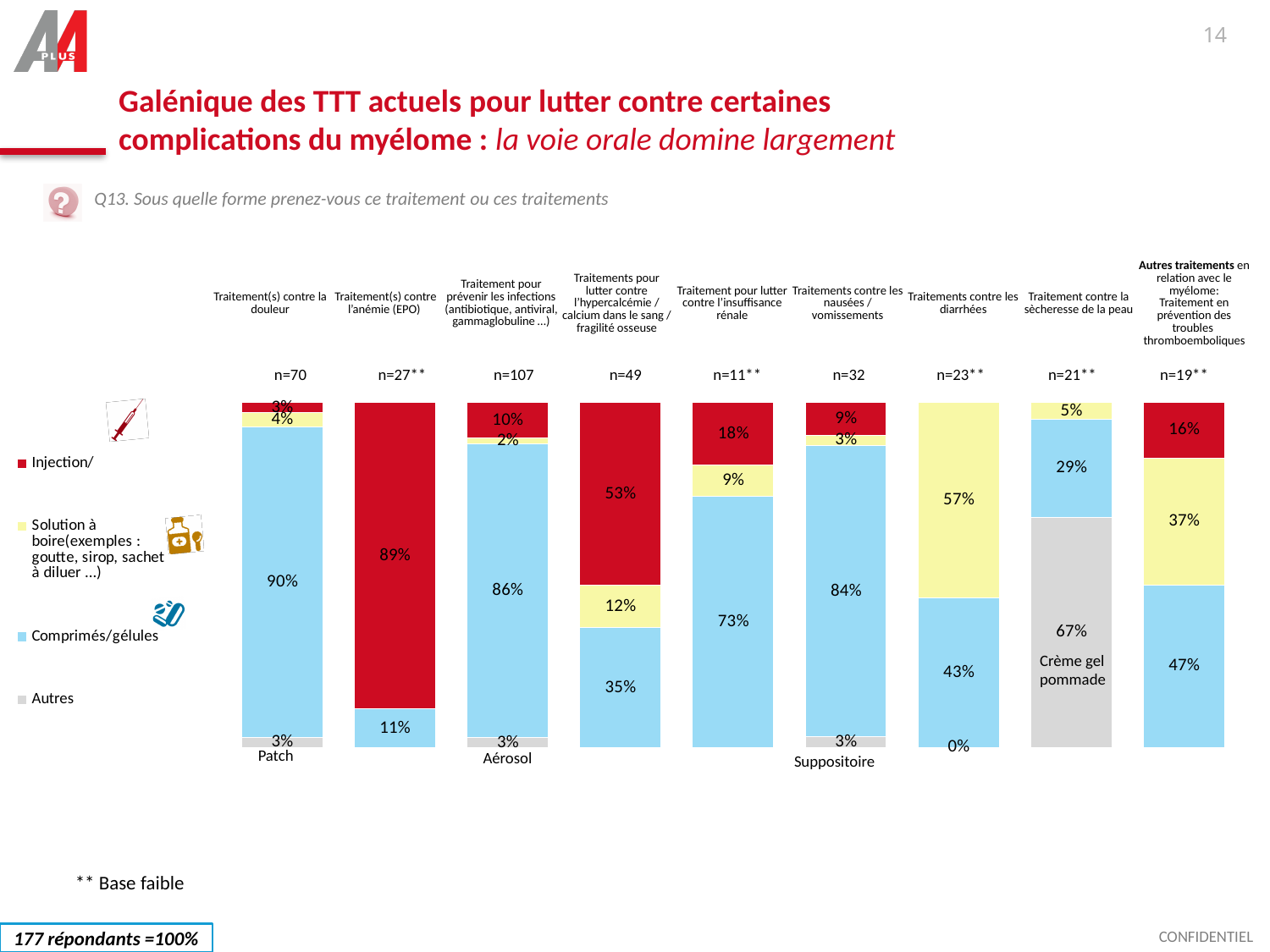
What is the sample size (n) shown for Traitement pour prévenir les infections? n=107 Which treatment category has the lowest Comprimés/gélules share? Traitement(s) contre l'anémie (EPO) What is the Injection share for Traitements pour lutter contre l'hypercalcémie / calcium dans le sang / fragilité osseuse? 53% How many series does the legend list? 4 How many treatment categories are plotted in the chart? 9 What kind of chart is shown on the slide? Stacked bar chart What is the Autres share for Traitement contre la sècheresse de la peau? 67% What is the difference between the Solution à boire share for Traitements contre les diarrhées and for Autres traitements? 20% What is the Injection share for Traitement(s) contre l'anémie (EPO)? 89% Which treatment category has the highest Injection share? Traitement(s) contre l'anémie (EPO) What is the Comprimés/gélules share for Traitement(s) contre la douleur? 90% Which is larger: the Comprimés/gélules share for Traitement pour lutter contre l'insuffisance rénale or for Traitements contre les nausées / vomissements? Traitements contre les nausées / vomissements